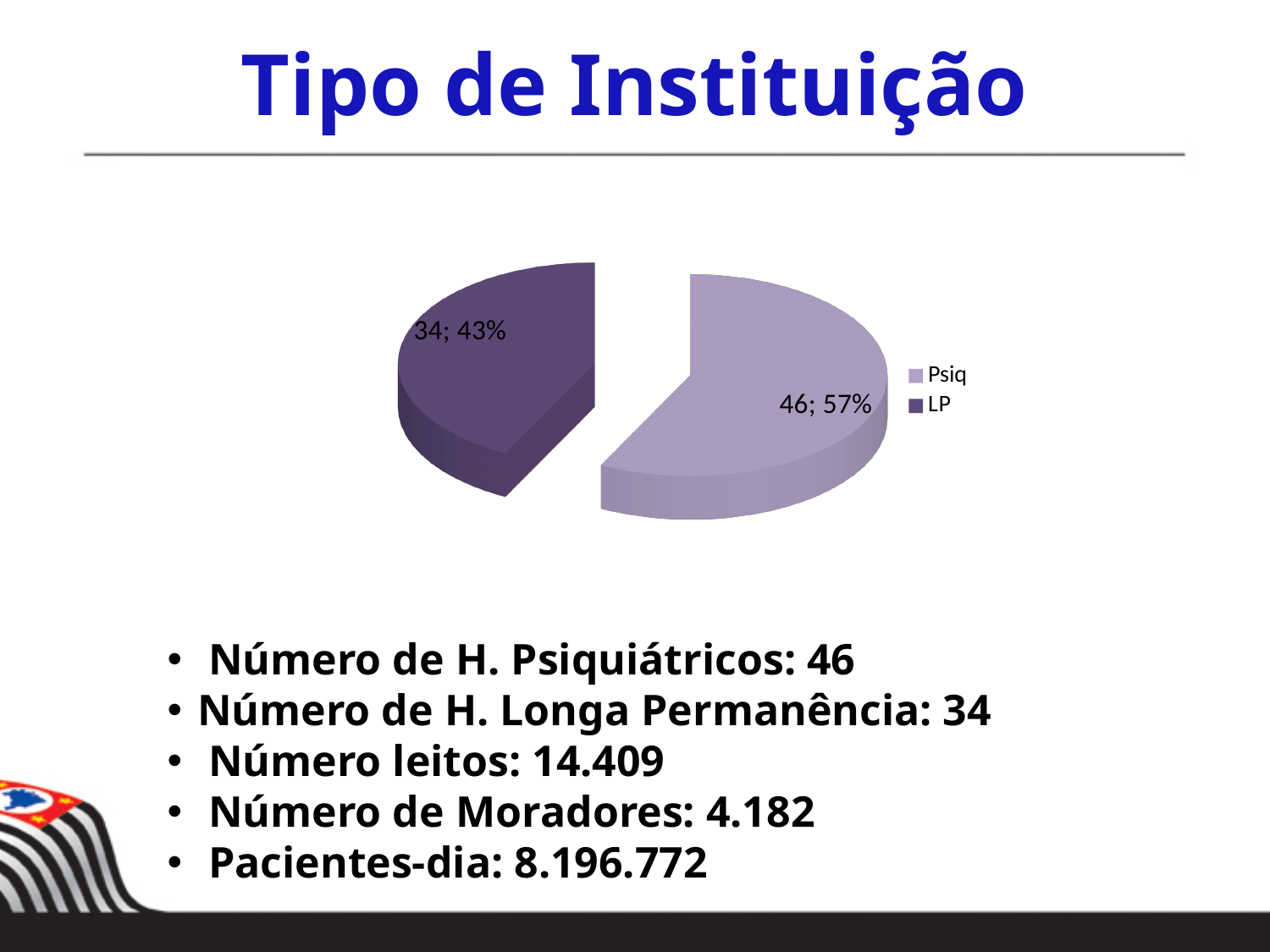
What share of the pie does the Psiq slice represent? 57% How many slices does the pie chart have? 2 Which slice is the smallest in the pie chart? LP What kind of chart is shown on the slide? pie chart What is the value shown for the Psiq slice? 46 What is the title of the slide containing the pie chart? Tipo de Instituição What is the value shown for the LP slice? 34 Which is larger, the Psiq slice or the LP slice? Psiq What is the difference between the Psiq value and the LP value? 12 Which slice is the largest in the pie chart? Psiq What share of the pie does the LP slice represent? 43% How many entries does the legend list? 2